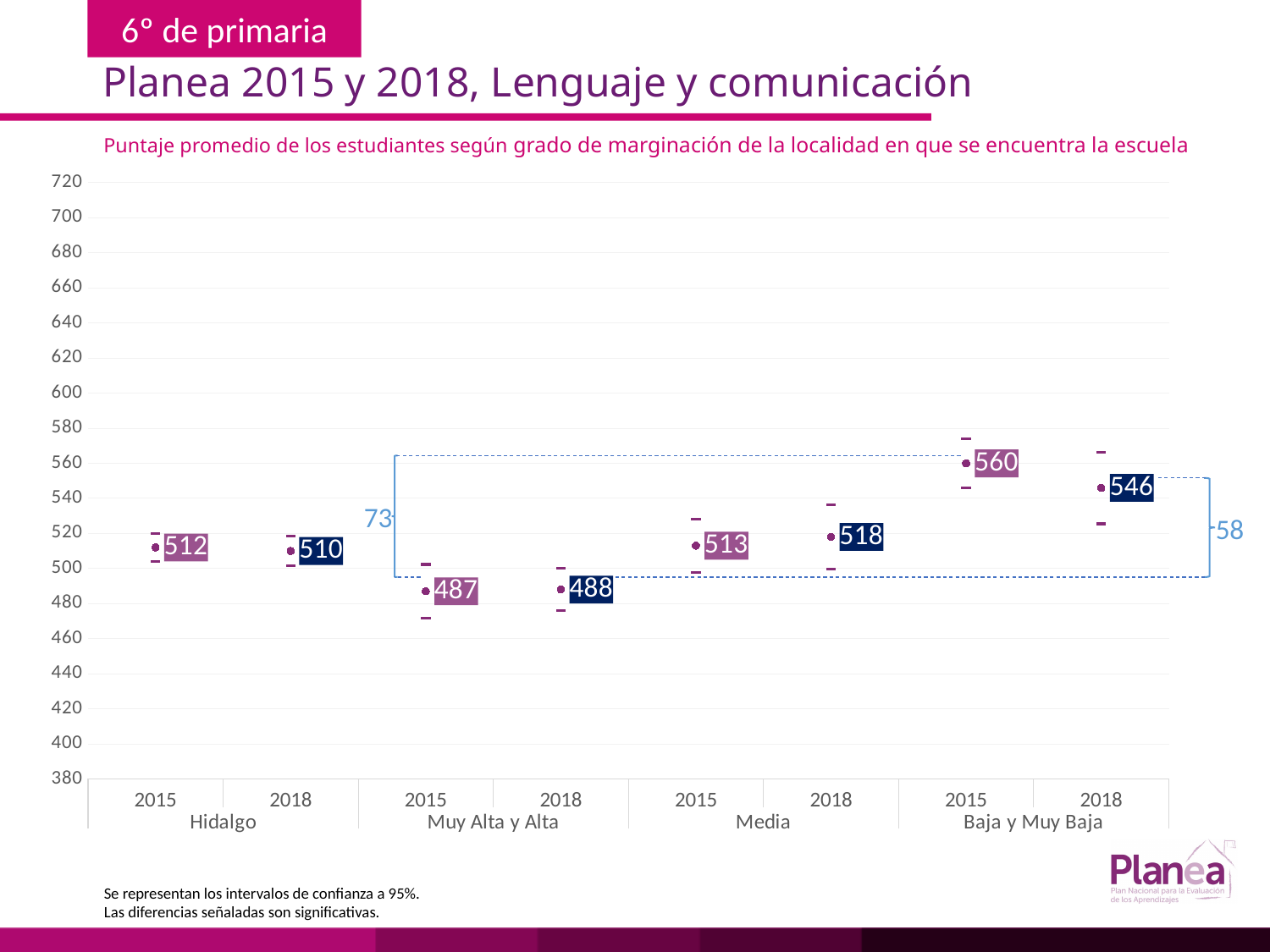
Did the score for the Media group rise or fall from 2015 to 2018? rise How many marginación groups (including Hidalgo) are shown on the x axis? 4 What is the average score for the Media group in 2018? 518 What is the difference between the 2015 and 2018 scores for the Baja y Muy Baja group? 14 What is the difference between the Media 2018 score and the Muy Alta y Alta 2018 score? 30 Which is larger, the Hidalgo 2015 score or the Hidalgo 2018 score? Hidalgo 2015 What is the average score for the Baja y Muy Baja group in 2015? 560 What is the average score for Hidalgo in 2015? 512 Which group and year has the lowest average score? Muy Alta y Alta, 2015 What is the average score for the Muy Alta y Alta marginación group in 2018? 488 Which group and year has the highest average score? Baja y Muy Baja, 2015 What is the subtitle printed above the chart? Puntaje promedio de los estudiantes según grado de marginación de la localidad en que se encuentra la escuela